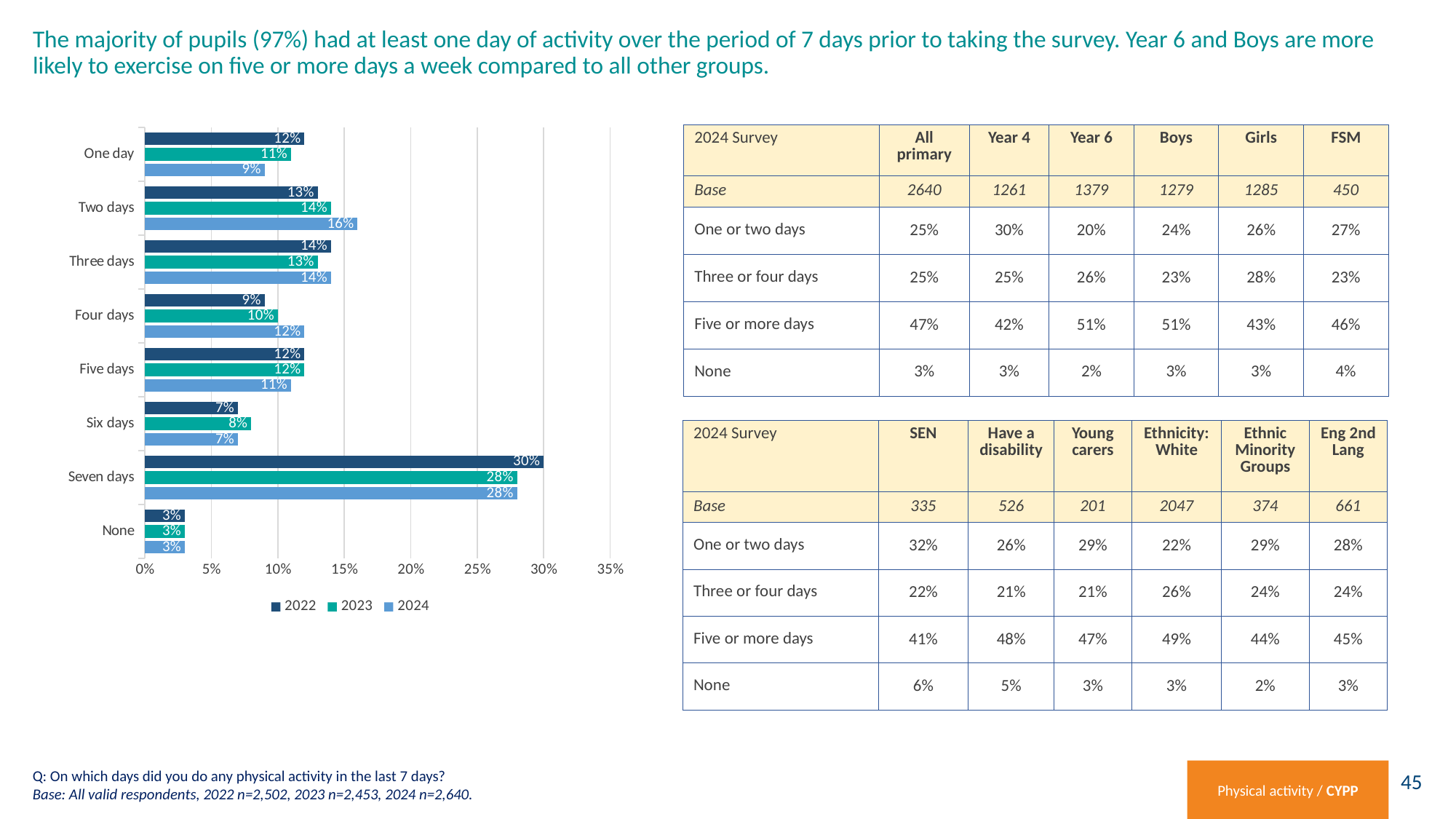
What is the 2022 value for Seven days? 30% Which category has the highest value for the 2024 series? Seven days What is the 2023 value for Four days? 10% Which series is shown in the darkest blue colour in the legend? 2022 Is the 2023 value for Seven days greater or less than 25%? greater What is the 2024 value for Two days? 16% Which is larger for Four days: the 2022 value or the 2024 value? 2024 How many categories are shown on the chart's vertical axis? 8 How many series does the chart legend list? 3 What is the difference between the 2022 and 2024 values for One day? 3% Which category has the lowest value for the 2022 series? None What kind of chart is shown on the slide? bar chart